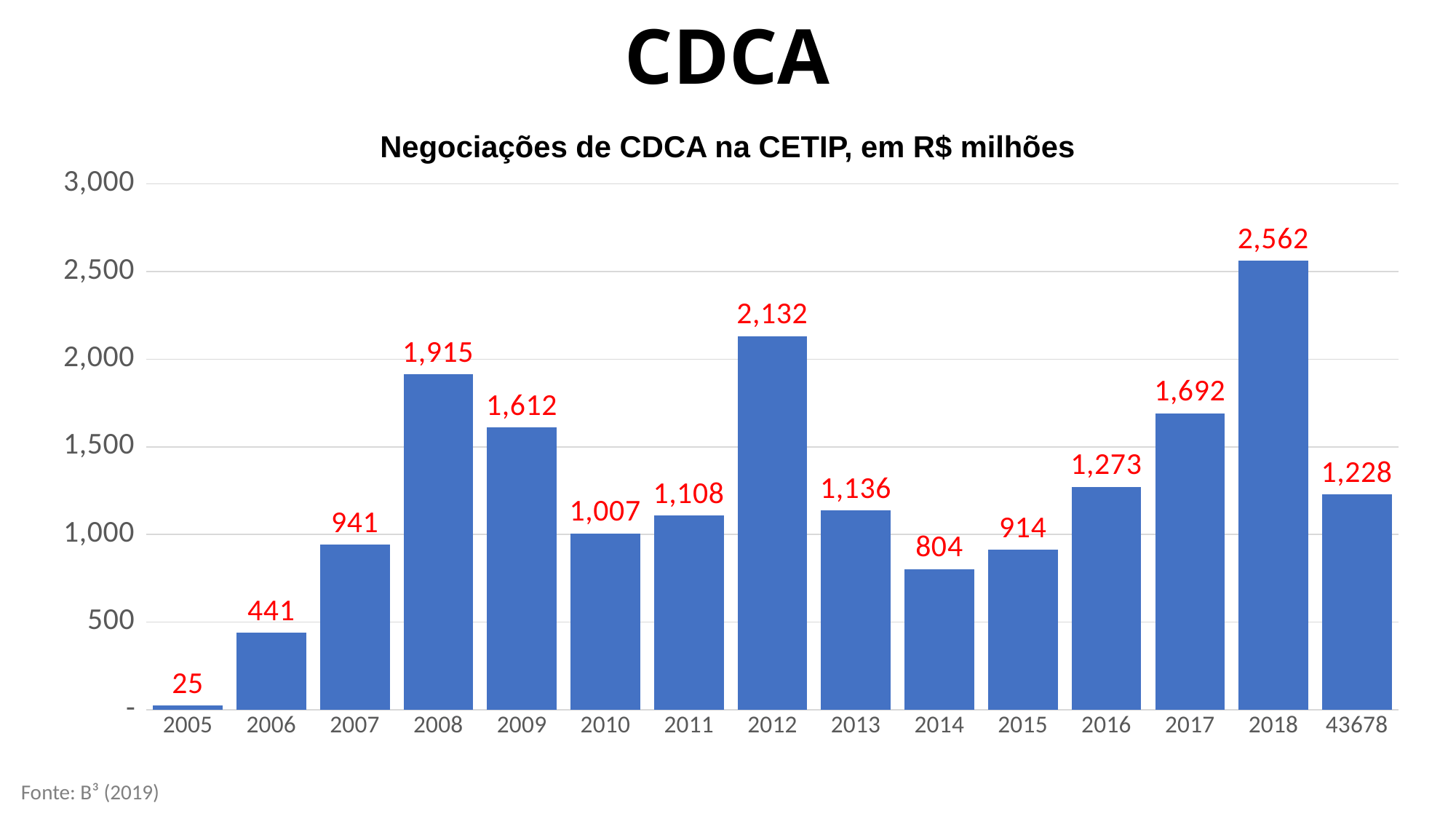
What is the title of the chart? Negociações de CDCA na CETIP, em R$ milhões What is the value for 2012? 2,132 What is the value for 2005? 25 Which year has the highest value? 2018 What kind of chart is shown? bar chart Is the value for 2014 greater or less than 1,000? less What is the value for the category labelled 43678? 1,228 Do the values rise or fall from 2005 to 2008? rise How many bars are shown in the chart? 15 What is the difference between the values for 2018 and 2017? 870 Which is larger, the value for 2008 or the value for 2009? 2008 Which year has the lowest value? 2005